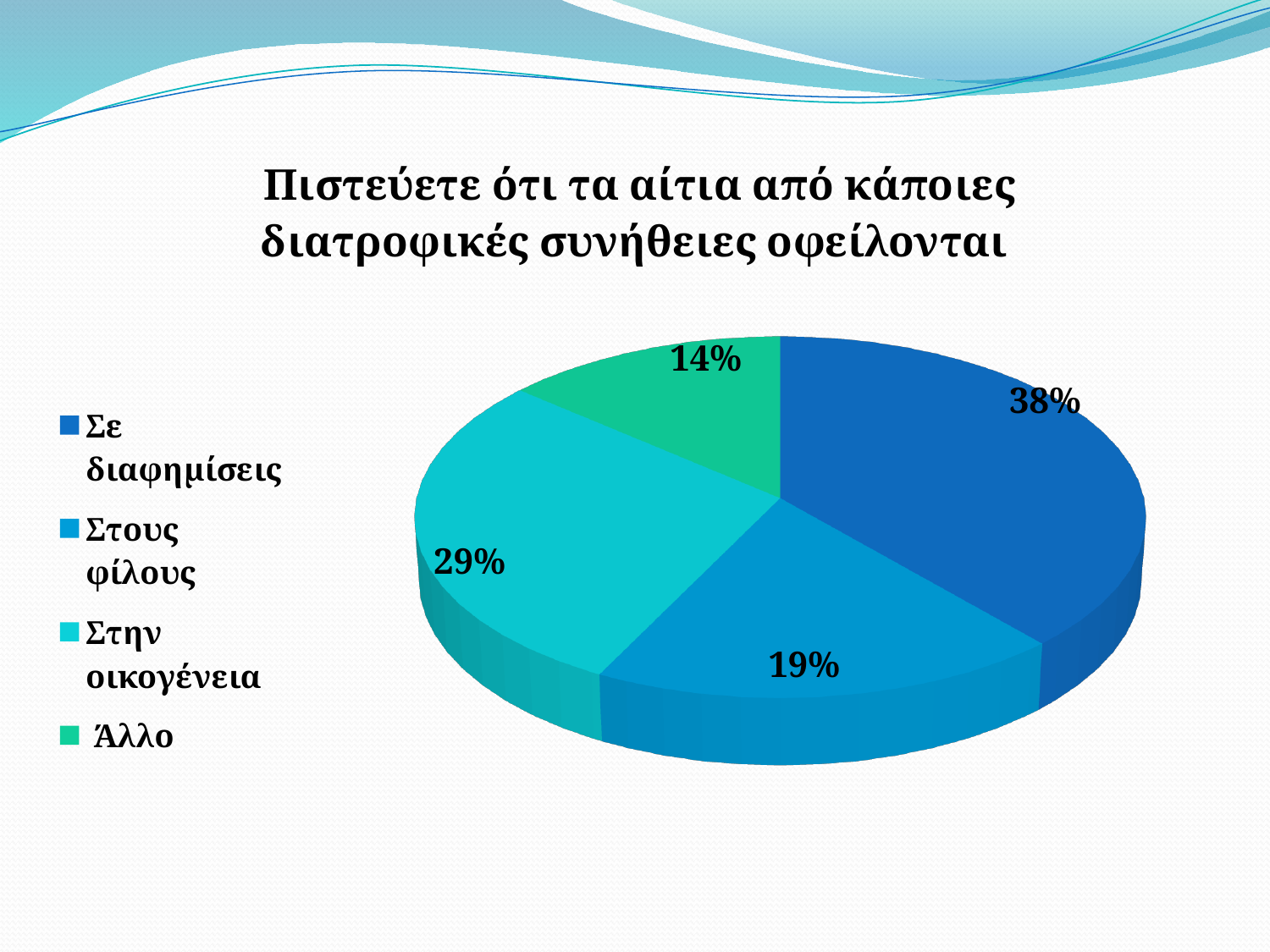
What percentage of the pie is labelled for 'Σε διαφημίσεις'? 38% What percentage of the pie is labelled for 'Άλλο'? 14% What is the difference in percentage points between 'Σε διαφημίσεις' and 'Στην οικογένεια'? 9 Which category has the largest slice of the pie? Σε διαφημίσεις What kind of chart is shown on the slide? Pie chart What is the difference in percentage points between 'Στους φίλους' and 'Άλλο'? 5 Which is larger, the slice for 'Στην οικογένεια' or the slice for 'Στους φίλους'? Στην οικογένεια What percentage of the pie is labelled for 'Στην οικογένεια'? 29% What percentage of the pie is labelled for 'Στους φίλους'? 19% What colour is the slice for 'Άλλο'? Green Which category has the smallest slice of the pie? Άλλο How many categories does the pie chart have? 4